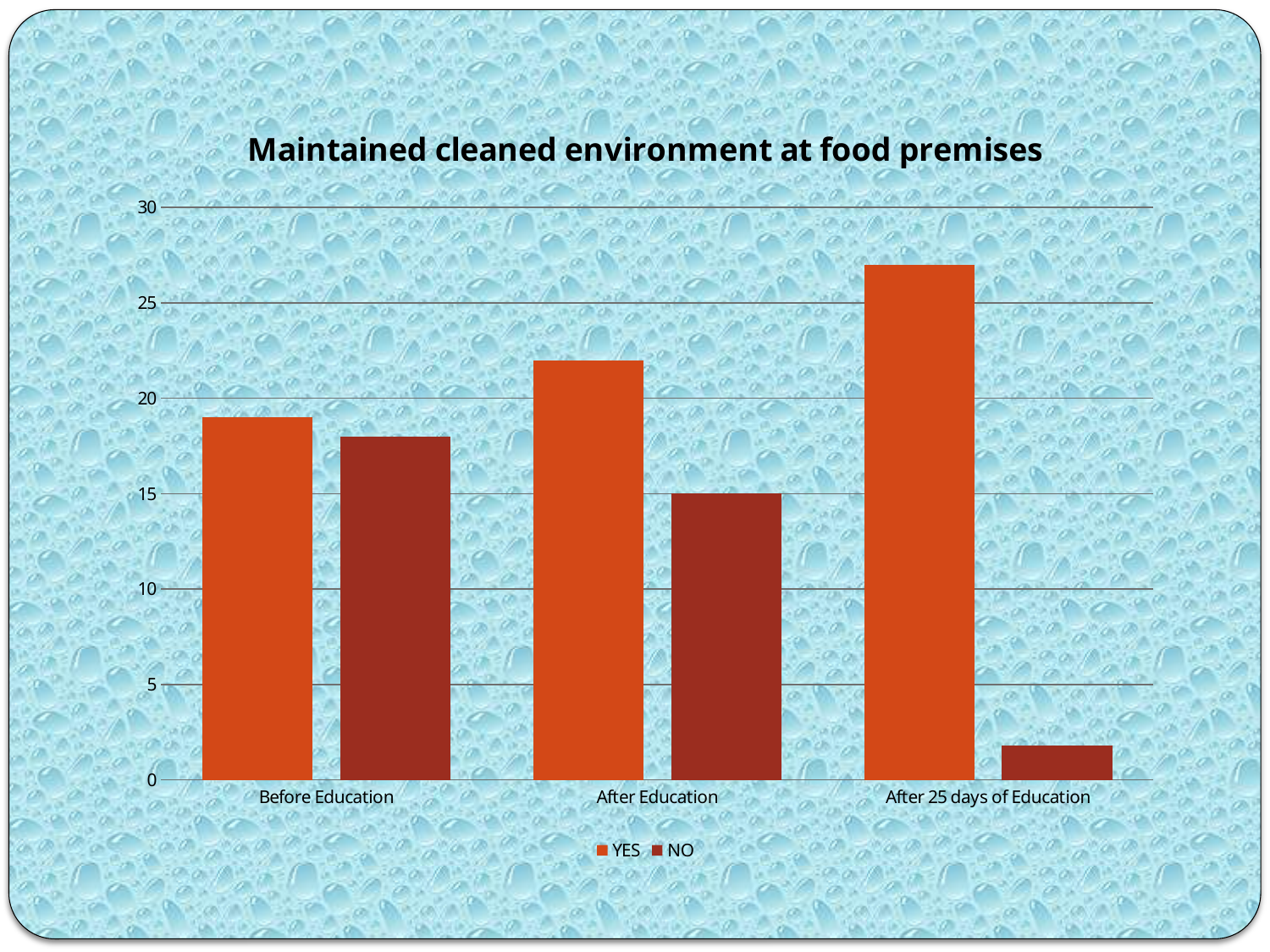
How many series does the legend list? 2 Is the NO value for After 25 days of Education greater or less than 5? less Is the YES value for After 25 days of Education greater or less than 25? greater Is the YES value for After Education greater or less than 20? greater What type of chart is shown on the slide? bar chart For After 25 days of Education, which is larger, YES or NO? YES Do the YES values rise or fall from Before Education to After 25 days of Education? rise For which category is the YES value highest? After 25 days of Education What is the title of the chart? Maintained cleaned environment at food premises For which category is the NO value lowest? After 25 days of Education What is the value of NO for After Education? 15 How many categories are shown on the x axis? 3